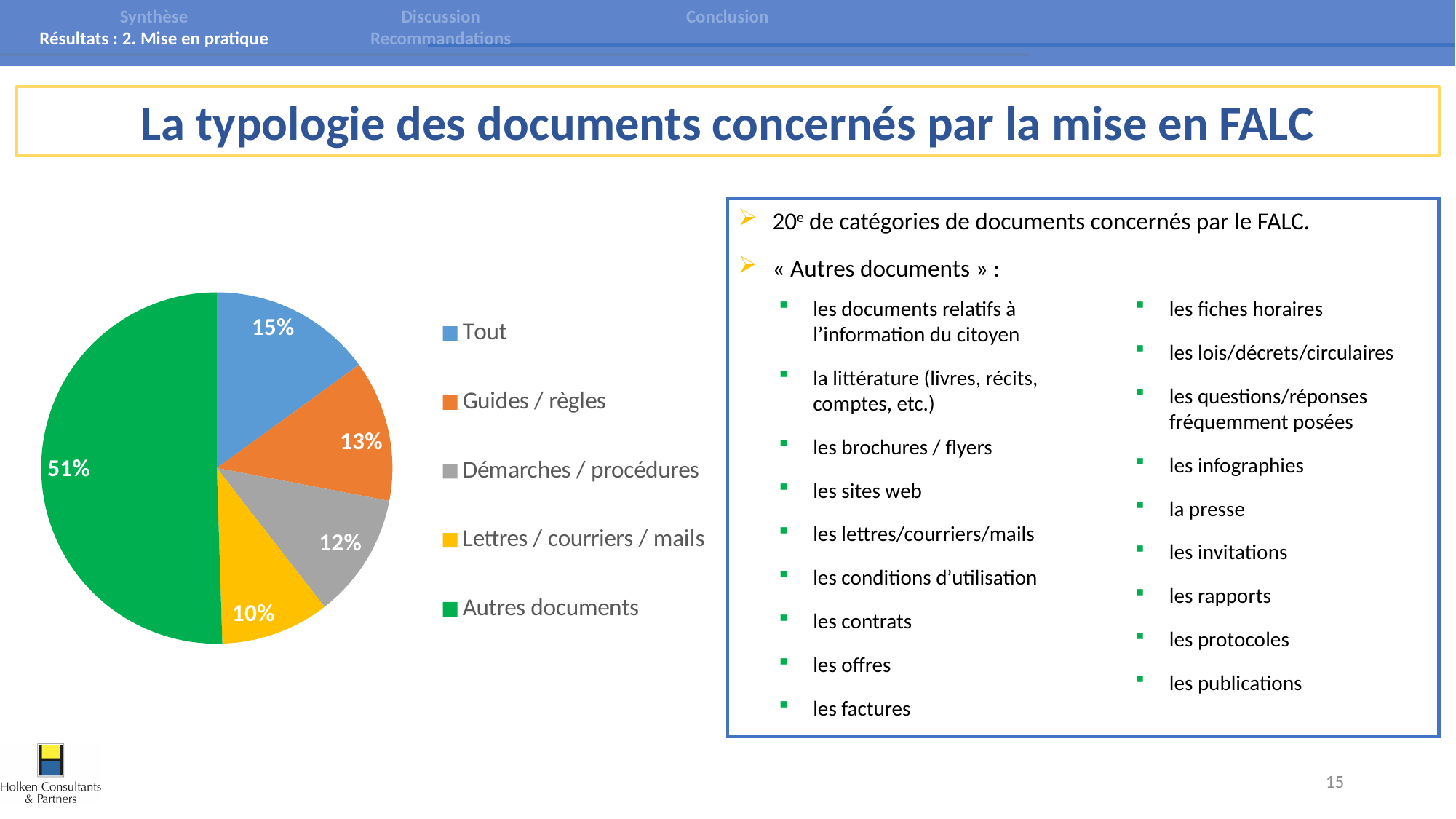
What share of the pie does "Autres documents" represent? 51% How many categories does the pie chart have? 5 What is the value shown for "Guides / règles"? 13% What is the value shown for "Lettres / courriers / mails"? 10% Which category has the largest slice of the pie? Autres documents Which is larger: the slice for "Tout" or the slice for "Guides / règles"? Tout What is the value shown for "Tout"? 15% What colour is the slice for "Lettres / courriers / mails"? yellow What is the difference in percentage points between "Autres documents" and "Tout"? 36 What is the value shown for "Démarches / procédures"? 12% Which category has the smallest slice of the pie? Lettres / courriers / mails What kind of chart is shown on the slide? pie chart